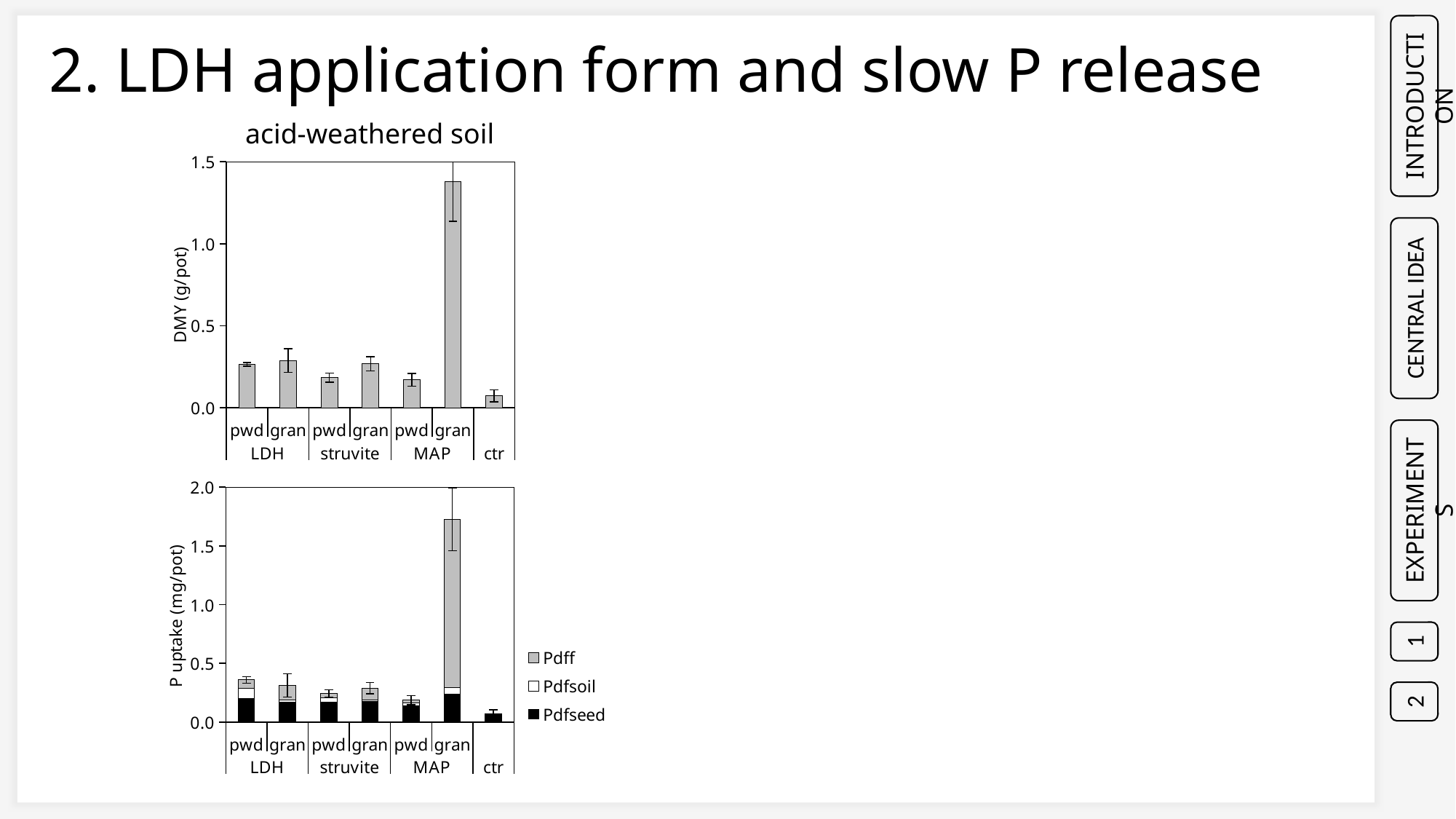
In the bottom chart (P uptake), is the total value for MAP gran greater or less than 1.5? greater In the top chart (DMY, acid-weathered soil), which bar has the lowest dry matter yield? ctr In the bottom chart (P uptake), which bar has the highest total P uptake? MAP gran What type of chart is the top chart (DMY, acid-weathered soil)? bar chart In the top chart (DMY, acid-weathered soil), which bar has the highest dry matter yield? MAP gran In the top chart (DMY, acid-weathered soil), which is larger: MAP pwd or MAP gran? MAP gran What is the y-axis label of the bottom chart? P uptake (mg/pot) How many bars are plotted in the top chart (DMY, acid-weathered soil)? 7 In the bottom chart (P uptake), which is larger in total: struvite gran or MAP gran? MAP gran In the top chart (DMY, acid-weathered soil), is the value for LDH pwd greater or less than 0.5? less In the top chart (DMY, acid-weathered soil), is the value for MAP gran greater or less than 1.0? greater How many series does the legend of the bottom chart (P uptake) list? 3